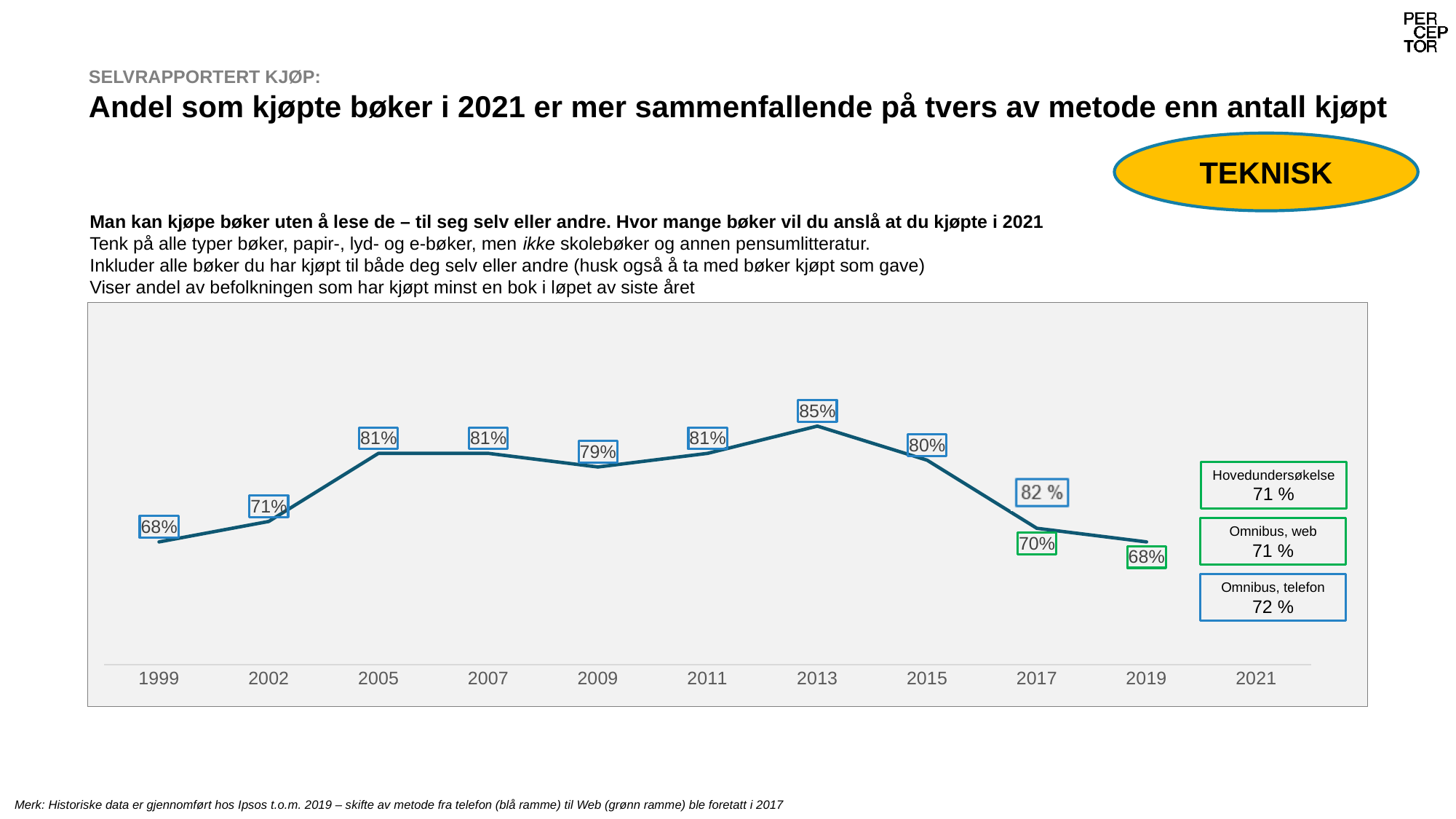
What is the difference between the values for 2013 and 2015? 5 percentage points What value is shown for 'Hovedundersøkelse' in 2021? 71 % Which year has the highest value on the line? 2013 What is the value in the green-framed label for 2017? 70% Which year has the larger value, 2002 or 2005? 2005 What is the value shown for 1999? 68% How many years are labelled on the x axis? 11 What kind of chart is shown on the slide? line chart Does the line rise or fall from 2013 to 2019? fall What is the value shown for 2009? 79% What is the value shown for 2013? 85% What value is shown for 'Omnibus, telefon' in 2021? 72 %